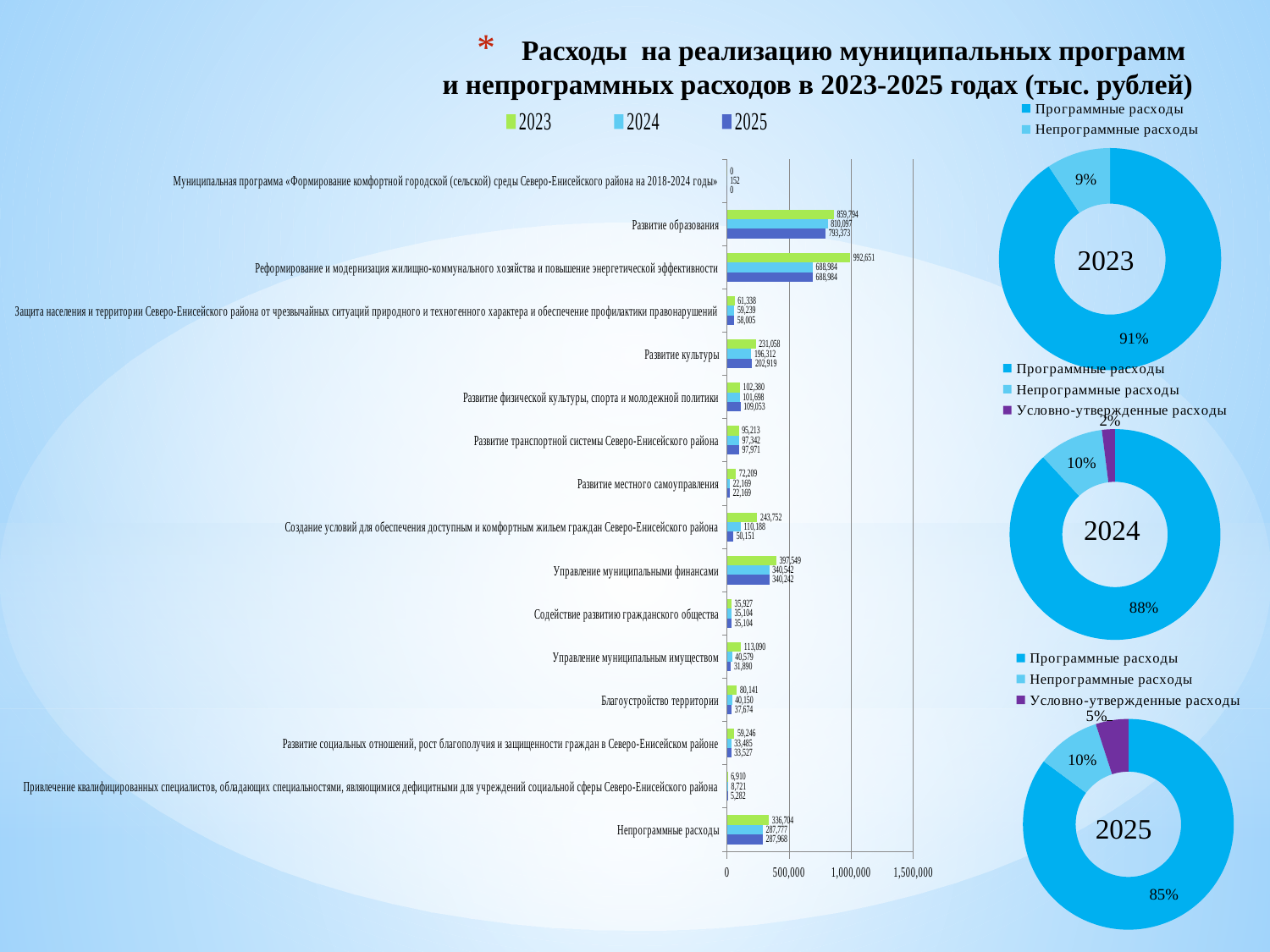
In the bar chart, what is the difference between the 2023 and 2025 values for Непрограммные расходы? 48,736 In the bar chart, what is the 2023 value for Развитие образования? 859,794 In the 2025 donut chart, what share is Условно-утвержденные расходы? 5% How many categories are shown in the bar chart? 16 What kind of chart is the chart on the left of the slide? bar chart In the bar chart, what is the 2024 value for Управление муниципальными финансами? 340,542 In the bar chart, which category has the highest 2023 value? Реформирование и модернизация жилищно-коммунального хозяйства и повышение энергетической эффективности In the bar chart, what is the 2025 value for Развитие культуры? 202,919 In the 2024 donut chart, what share is Программные расходы? 88% How many series does the legend of the bar chart list? 3 In the bar chart, which is larger for Развитие физической культуры, спорта и молодежной политики: the 2023 value or the 2025 value? 2025 In the 2023 donut chart, what share is Непрограммные расходы? 9%